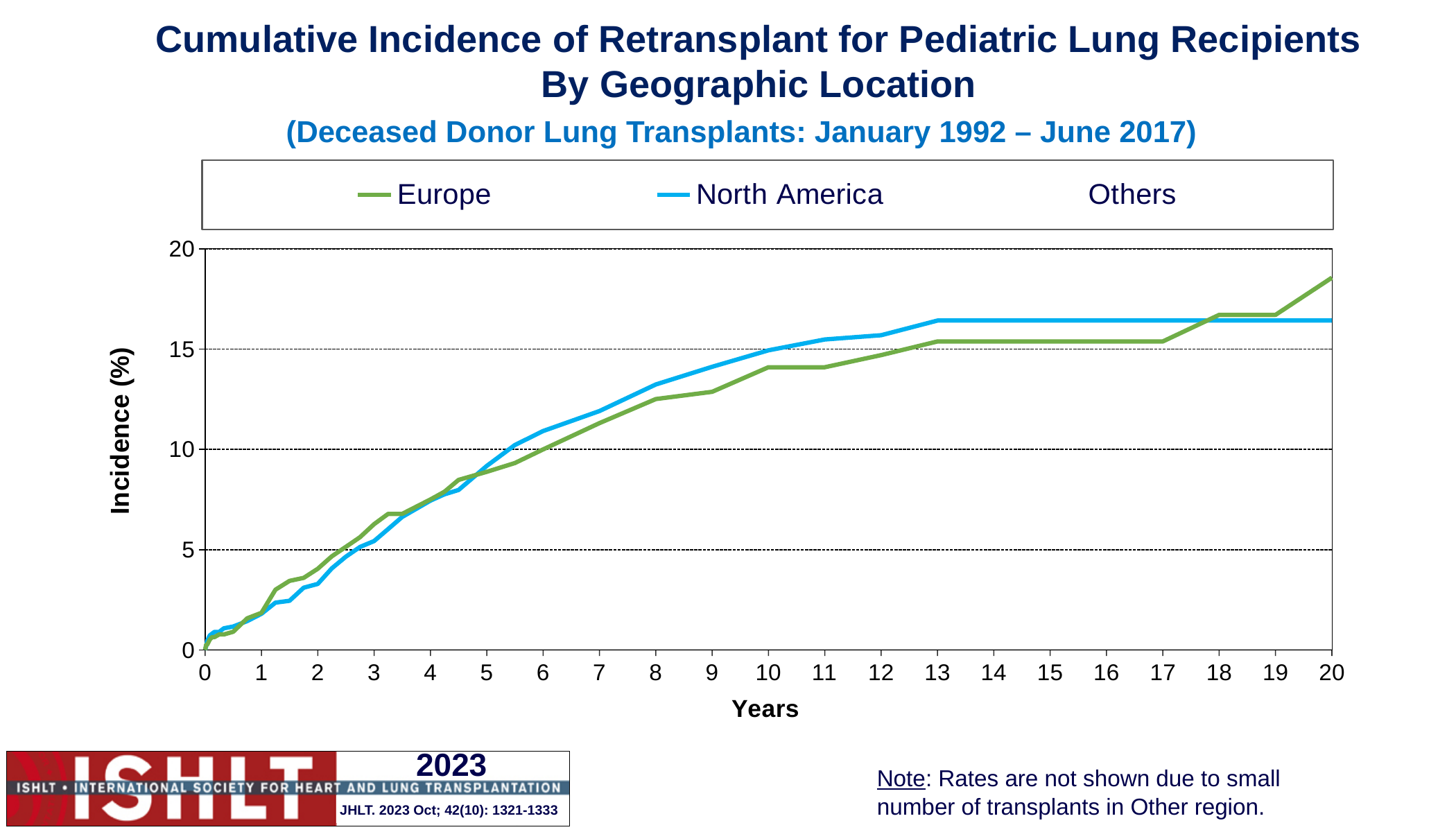
Is the value for Europe at year 20 greater or less than 15? greater Is the value for North America at year 13 greater or less than 15? greater Which series listed in the legend has no line plotted on the chart? Others Is the value for Europe at year 5 greater or less than 10? less At year 15, which series has the higher cumulative incidence, Europe or North America? North America Does the cumulative incidence for Europe rise or fall as the years increase? Rise At year 20, which series has the higher cumulative incidence, Europe or North America? Europe How many series does the legend list? 3 What kind of chart is shown on the slide? Line chart What is the label of the y axis? Incidence (%)